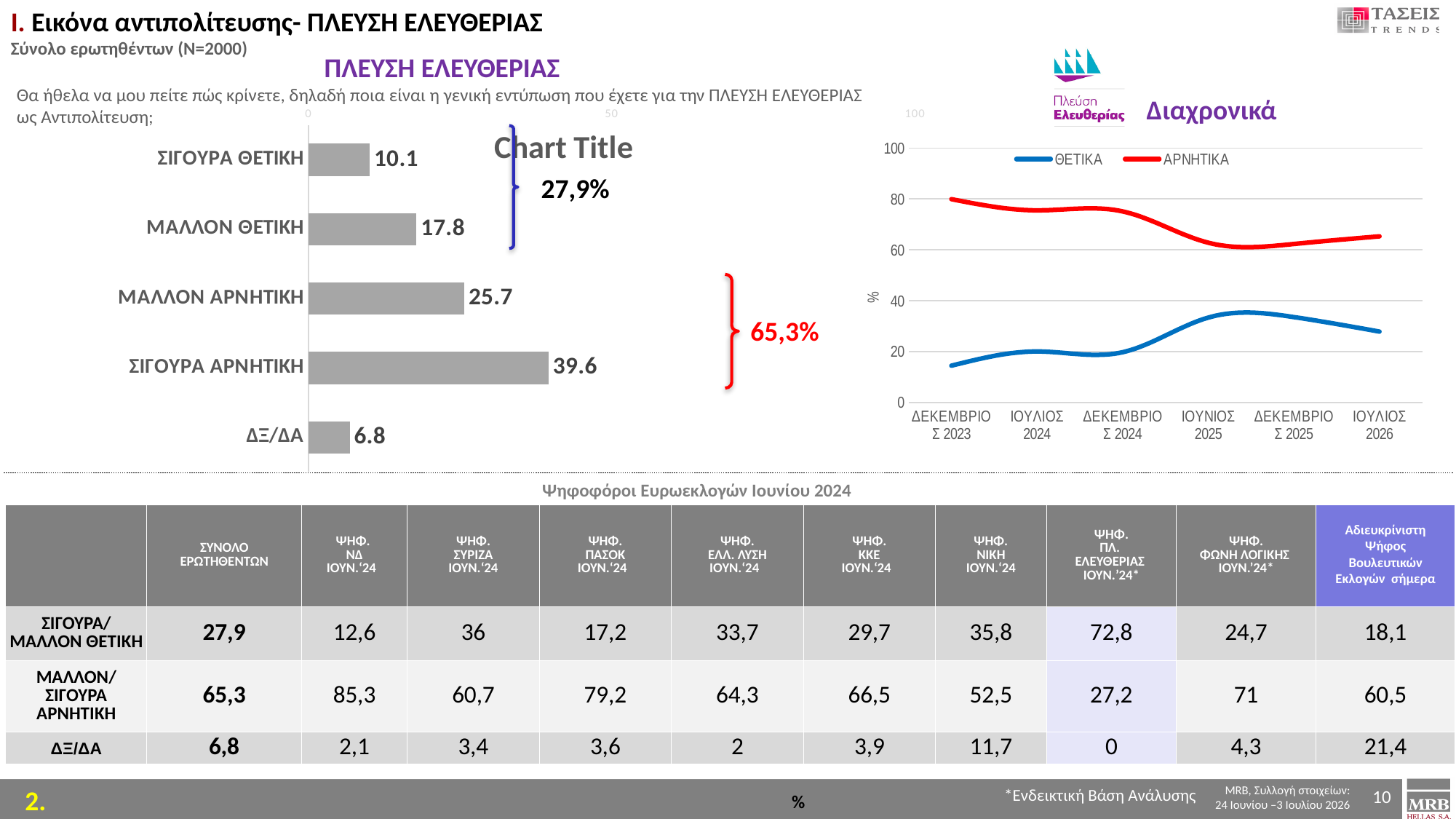
How many categories does the bar chart on the left show? 5 In the bar chart on the left, what is the value for ΜΑΛΛΟΝ ΘΕΤΙΚΗ? 17.8 In the bar chart on the left, what is the value for ΔΞ/ΔΑ? 6.8 In the bar chart on the left, what is the value for ΣΙΓΟΥΡΑ ΑΡΝΗΤΙΚΗ? 39.6 In the bar chart on the left, which is larger: ΜΑΛΛΟΝ ΘΕΤΙΚΗ or ΣΙΓΟΥΡΑ ΘΕΤΙΚΗ? ΜΑΛΛΟΝ ΘΕΤΙΚΗ In the bar chart on the left, which category has the highest value? ΣΙΓΟΥΡΑ ΑΡΝΗΤΙΚΗ How many series does the legend of the Διαχρονικά line chart list? 2 In the Διαχρονικά line chart, is the ΑΡΝΗΤΙΚΑ value for ΔΕΚΕΜΒΡΙΟΣ 2023 greater or less than 60? greater In the Διαχρονικά line chart, does the ΘΕΤΙΚΑ line rise or fall between ΔΕΚΕΜΒΡΙΟΣ 2024 and ΙΟΥΝΙΟΣ 2025? rise What kind of chart is the chart on the left of the slide? bar chart In the bar chart on the left, what is the difference between ΣΙΓΟΥΡΑ ΑΡΝΗΤΙΚΗ and ΜΑΛΛΟΝ ΑΡΝΗΤΙΚΗ? 13.9 In the bar chart on the left, which category has the lowest value? ΔΞ/ΔΑ